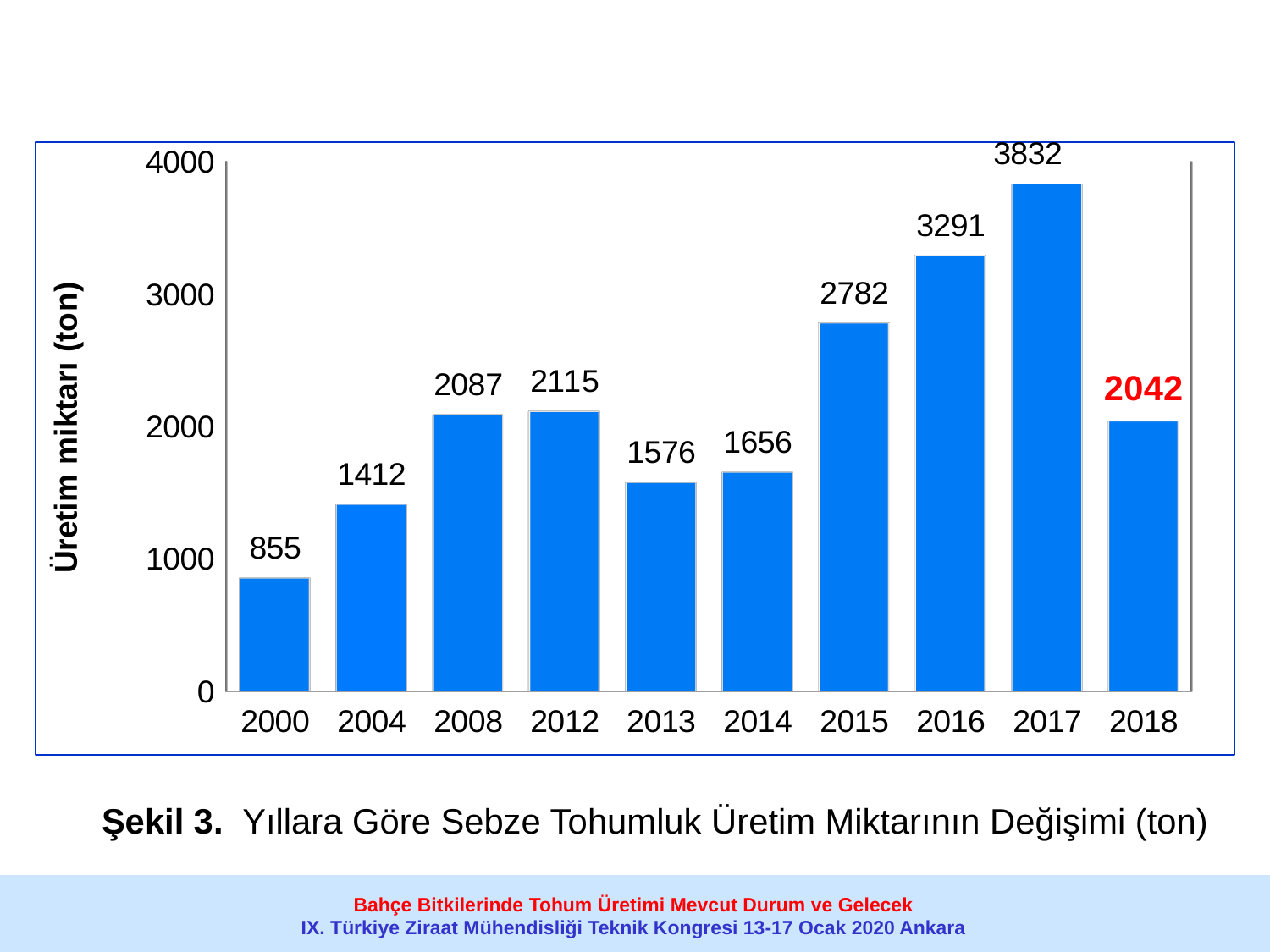
What is the production amount for 2000? 855 Which year has the lowest production amount? 2000 What is the production amount for 2017? 3832 What is the difference between the production amounts for 2017 and 2018? 1790 How many years are shown on the x axis? 10 Which year has the highest production amount? 2017 What is the production amount for 2018? 2042 Is the value for 2015 greater or less than 3000? less Do the values rise or fall from 2014 to 2017? rise What is the label of the y axis? Üretim miktarı (ton) Which year has a larger production amount, 2013 or 2014? 2014 What kind of chart is shown on the slide? bar chart